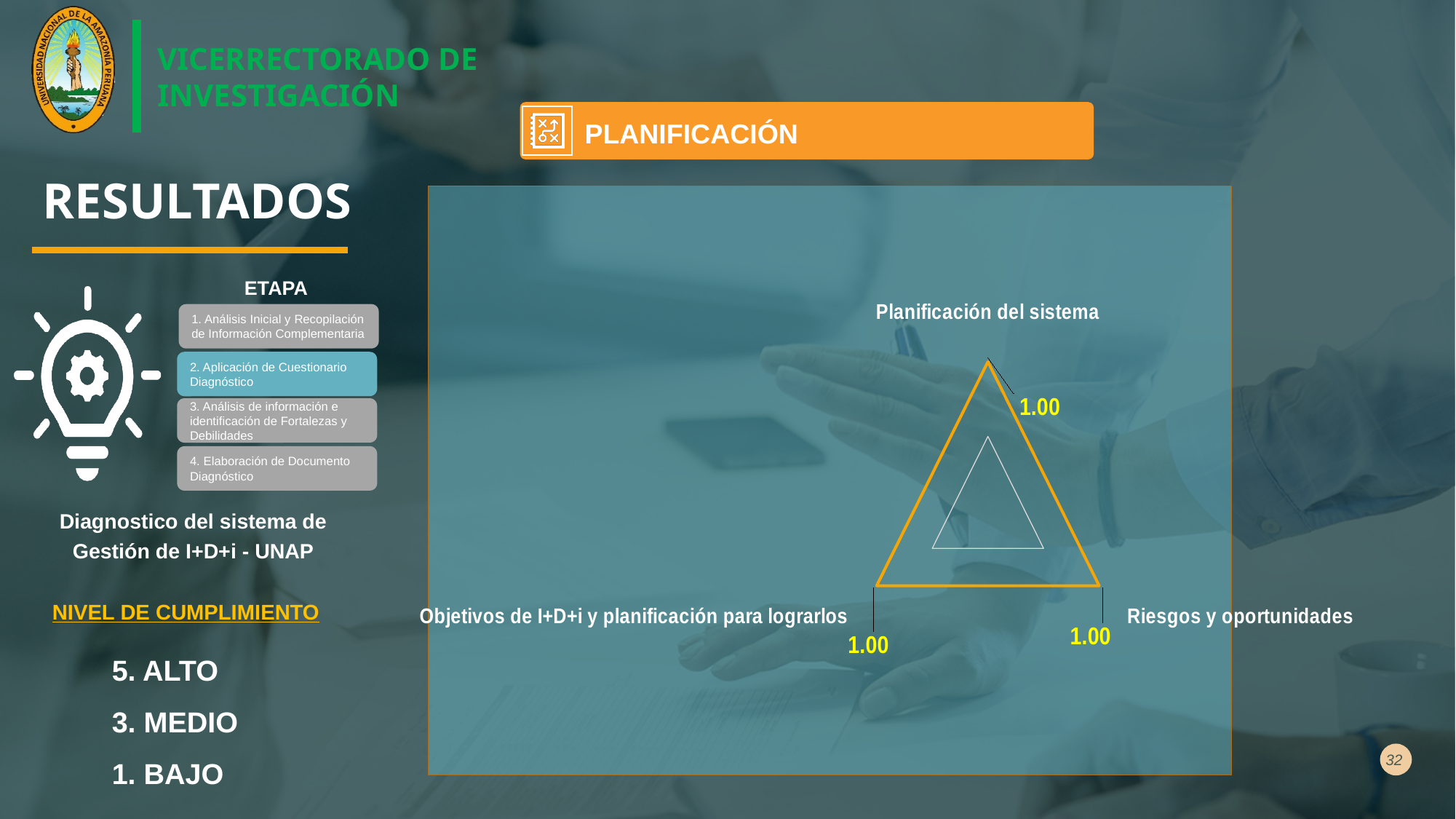
How many categories (axes) does the radar chart have? 3 Is the value for "Riesgos y oportunidades" greater or less than 3? less What is the value for "Riesgos y oportunidades" in the radar chart? 1.00 What colour is the plotted data line in the radar chart? Orange Is the value for "Planificación del sistema" greater or less than 5? less What kind of chart is shown on the slide? Radar chart What is the difference between the values for "Planificación del sistema" and "Riesgos y oportunidades"? 0.00 What is the value for "Objetivos de I+D+i y planificación para lograrlos" in the radar chart? 1.00 Which category label appears at the top vertex of the radar chart? Planificación del sistema What is the value for "Planificación del sistema" in the radar chart? 1.00